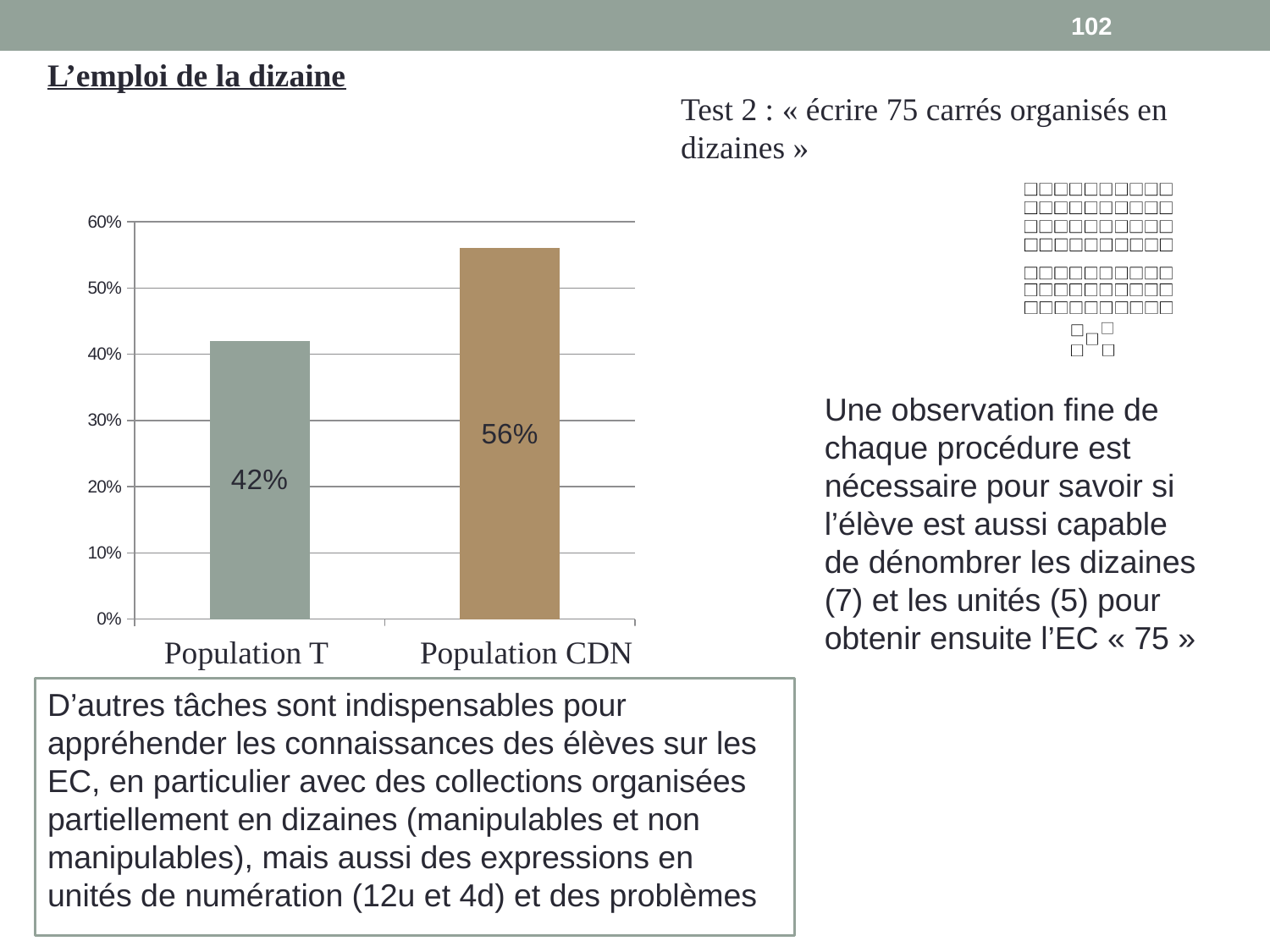
What colour is the bar for Population CDN? brown What is the highest value shown on the vertical axis of the chart? 60% Which is larger, the value for Population T or the value for Population CDN? Population CDN How many categories are shown on the chart? 2 What is the value for Population CDN? 56% Which category has the highest value? Population CDN What is the value for Population T? 42% What is the difference between the values for Population CDN and Population T? 14% What kind of chart is shown on the slide? bar chart Is the value for Population T greater or less than 40%? greater Is the value for Population CDN greater or less than 60%? less Which category has the lowest value? Population T